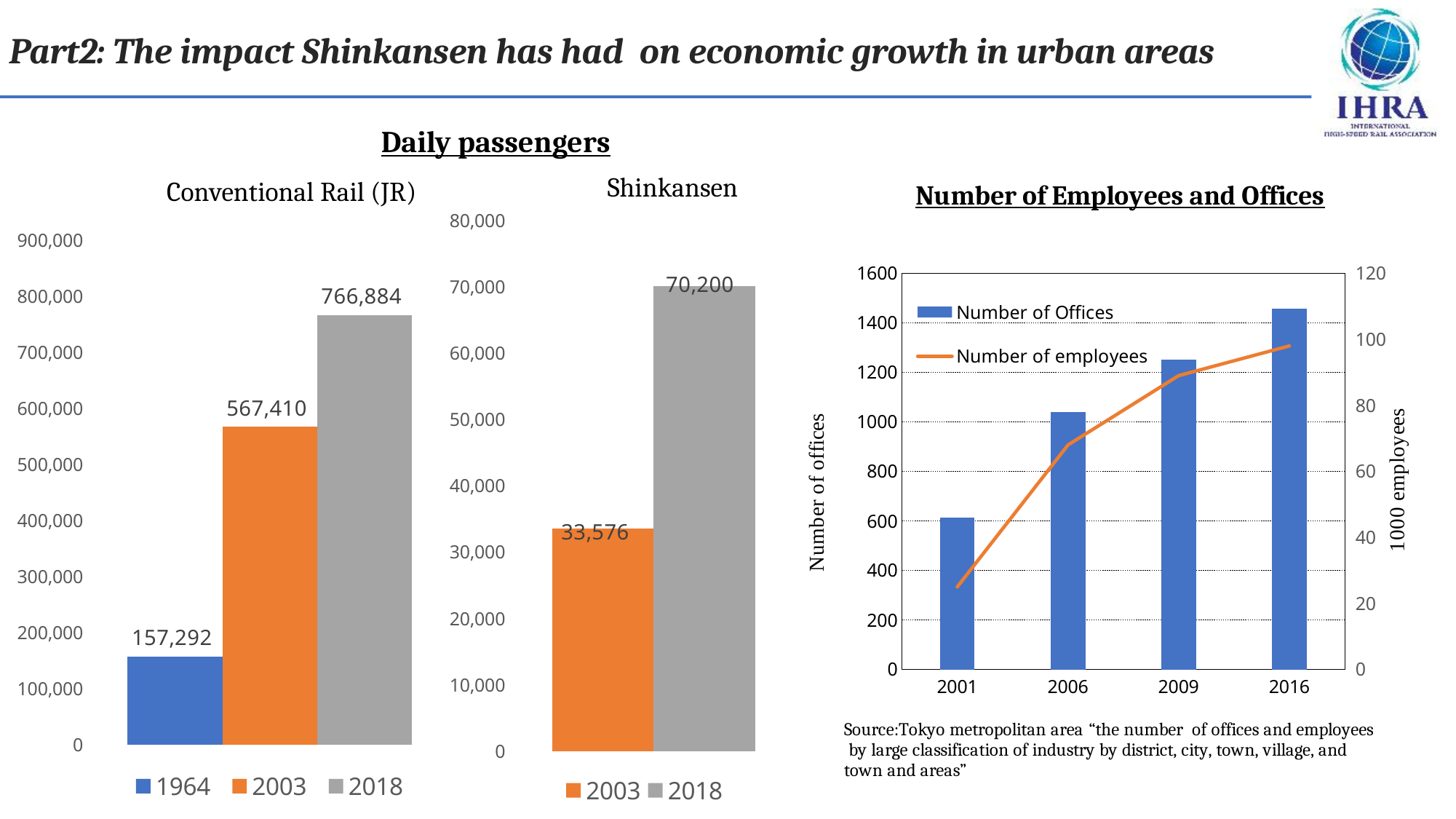
In the Conventional Rail (JR) chart, what is the difference between the 2018 and 2003 values? 199,474 How many series does the legend of the Conventional Rail (JR) chart list? 3 In the Number of Employees and Offices chart, is the Number of Offices for 2001 greater or less than 800? less In the Number of Employees and Offices chart, does the Number of employees line rise or fall from 2001 to 2016? rise In the Shinkansen chart, what is the value for 2003? 33,576 In the Conventional Rail (JR) chart, what is the value for 1964? 157,292 In the Shinkansen chart, what is the value for 2018? 70,200 In the Conventional Rail (JR) chart, which year has the lowest value? 1964 In the Number of Employees and Offices chart, how many years are shown on the x axis? 4 In the Number of Employees and Offices chart, is the Number of Offices for 2016 greater or less than 1400? greater In the Conventional Rail (JR) chart, what is the value for 2018? 766,884 In the Shinkansen chart, what is the difference between the 2018 and 2003 values? 36,624